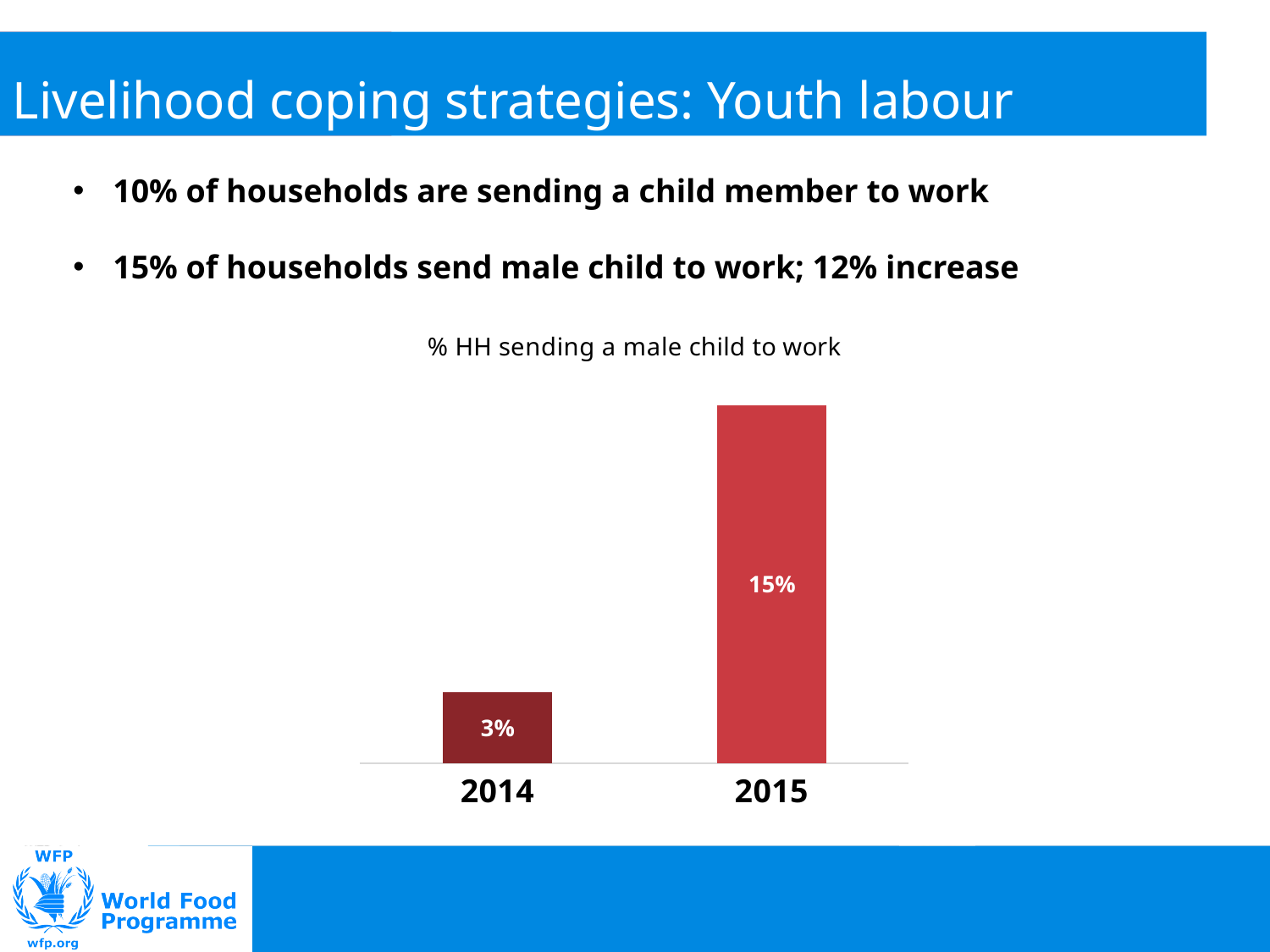
Which year has the highest percentage of households sending a male child to work? 2015 What kind of chart is shown on the slide? Bar chart What is the value for 2014 in the chart? 3% How many categories are shown on the x axis of the chart? 2 What is the title of the chart? % HH sending a male child to work What is the difference between the 2015 and 2014 values in the chart? 12% What is the value for 2015 in the chart? 15% Do the values rise or fall from 2014 to 2015? Rise What colour are the bars in the chart? Red Which is larger, the value for 2014 or the value for 2015? 2015 Which year has the lowest percentage of households sending a male child to work? 2014